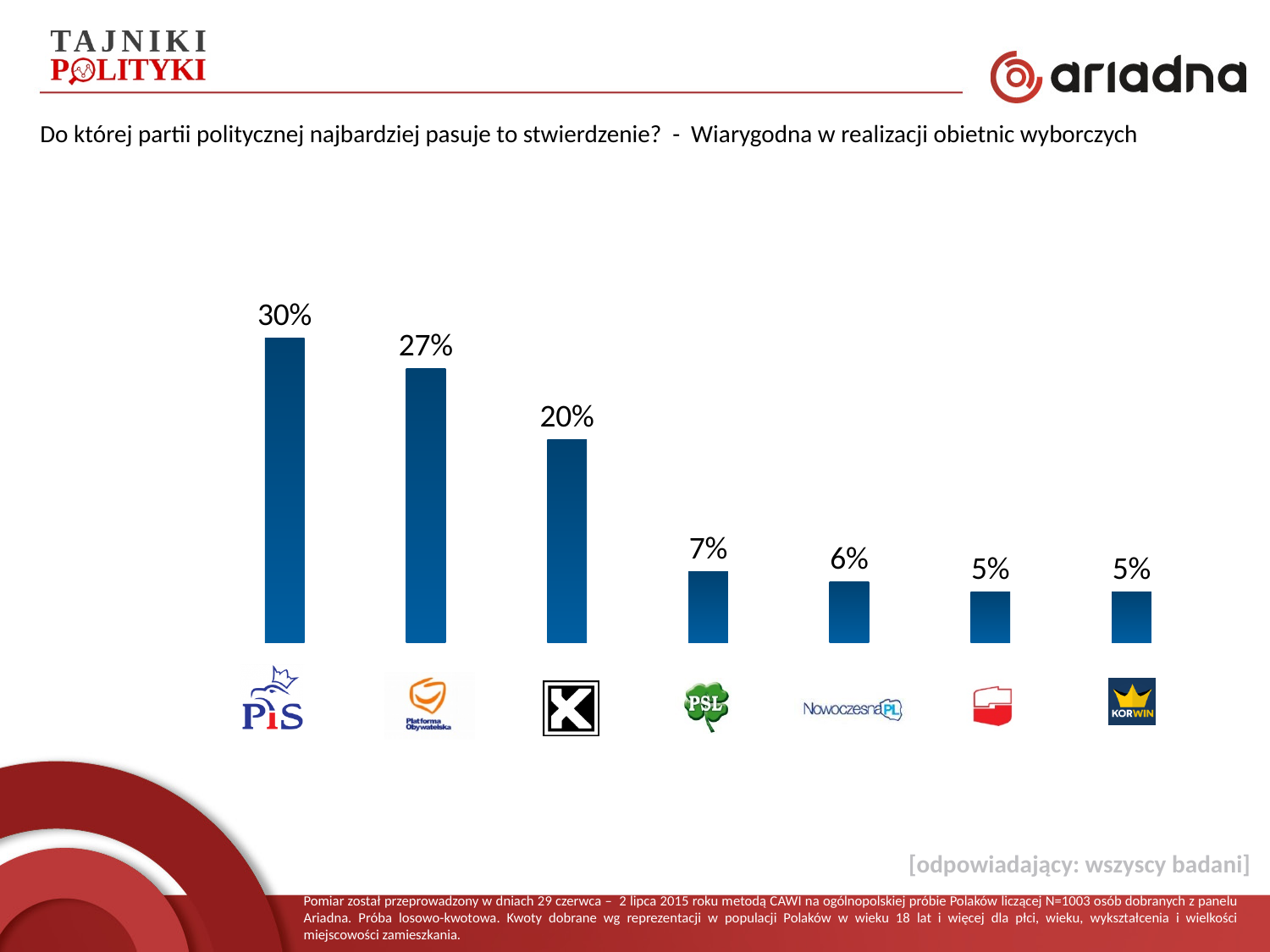
Which party has the highest value on the chart? PiS What is the difference between the values for PiS and Platforma Obywatelska? 3 percentage points What percentage is shown for Platforma Obywatelska? 27% What percentage is shown for PSL? 7% Do the values rise or fall from left to right across the chart? Fall How many bars are shown on the chart? 7 What type of chart is shown on the slide? Bar chart What value does the third bar from the left show? 20% What percentage is shown for Nowoczesna PL? 6% What percentage is shown for PiS? 30% Which has a larger value, PSL or Nowoczesna PL? PSL What percentage is shown for KORWIN? 5%